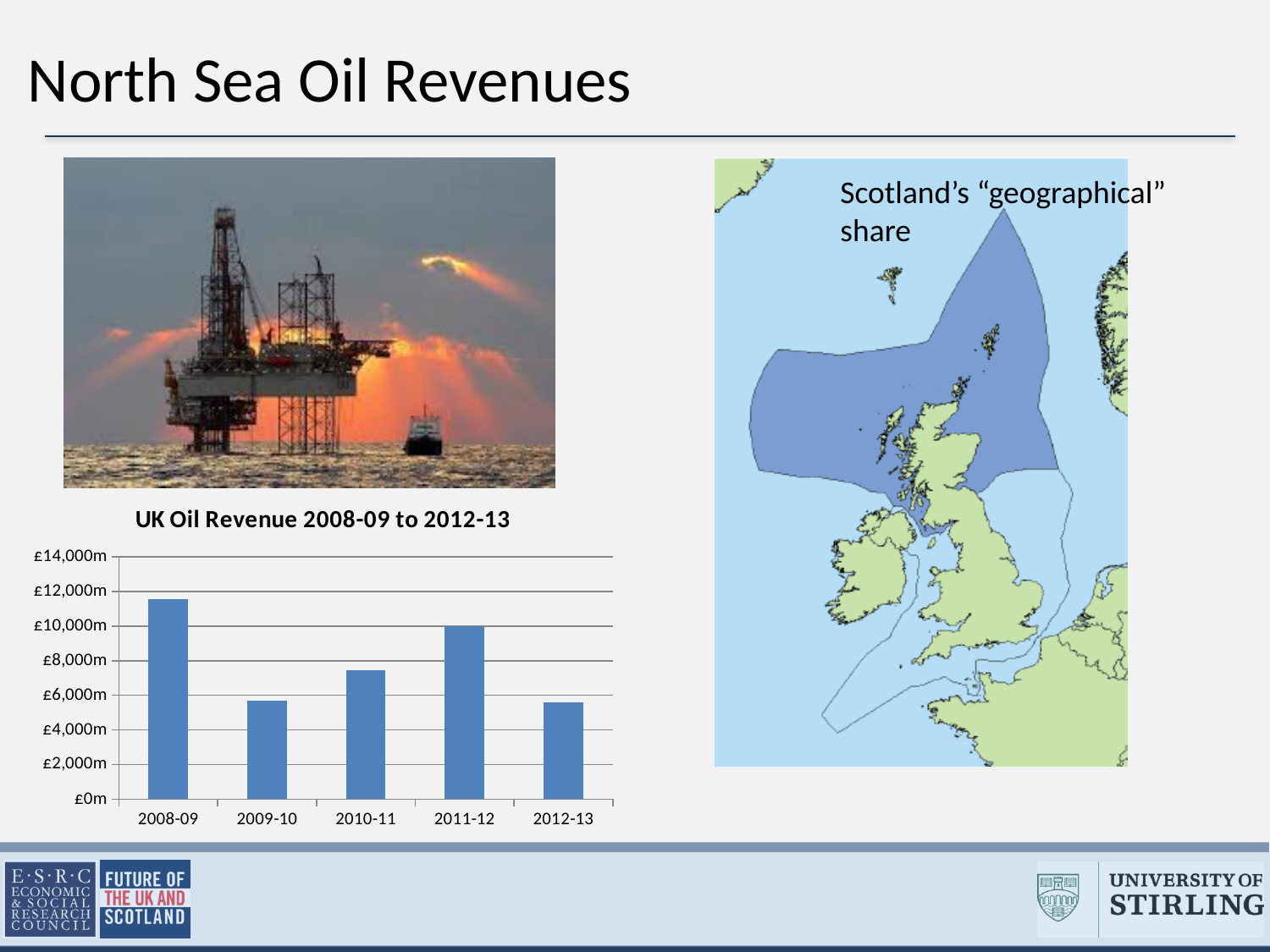
Which year has the larger UK oil revenue, 2009-10 or 2010-11? 2010-11 Is the UK oil revenue for 2008-09 greater or less than £10,000m? greater What kind of chart is shown on the slide? bar chart Does UK oil revenue rise or fall from 2008-09 to 2009-10? fall Which year has the highest UK oil revenue in the chart? 2008-09 Is the UK oil revenue for 2012-13 greater or less than £8,000m? less Is the UK oil revenue for 2011-12 greater or less than £8,000m? greater How many years are plotted in the UK Oil Revenue chart? 5 What is the title of the chart on the slide? UK Oil Revenue 2008-09 to 2012-13 Which year has the larger UK oil revenue, 2008-09 or 2011-12? 2008-09